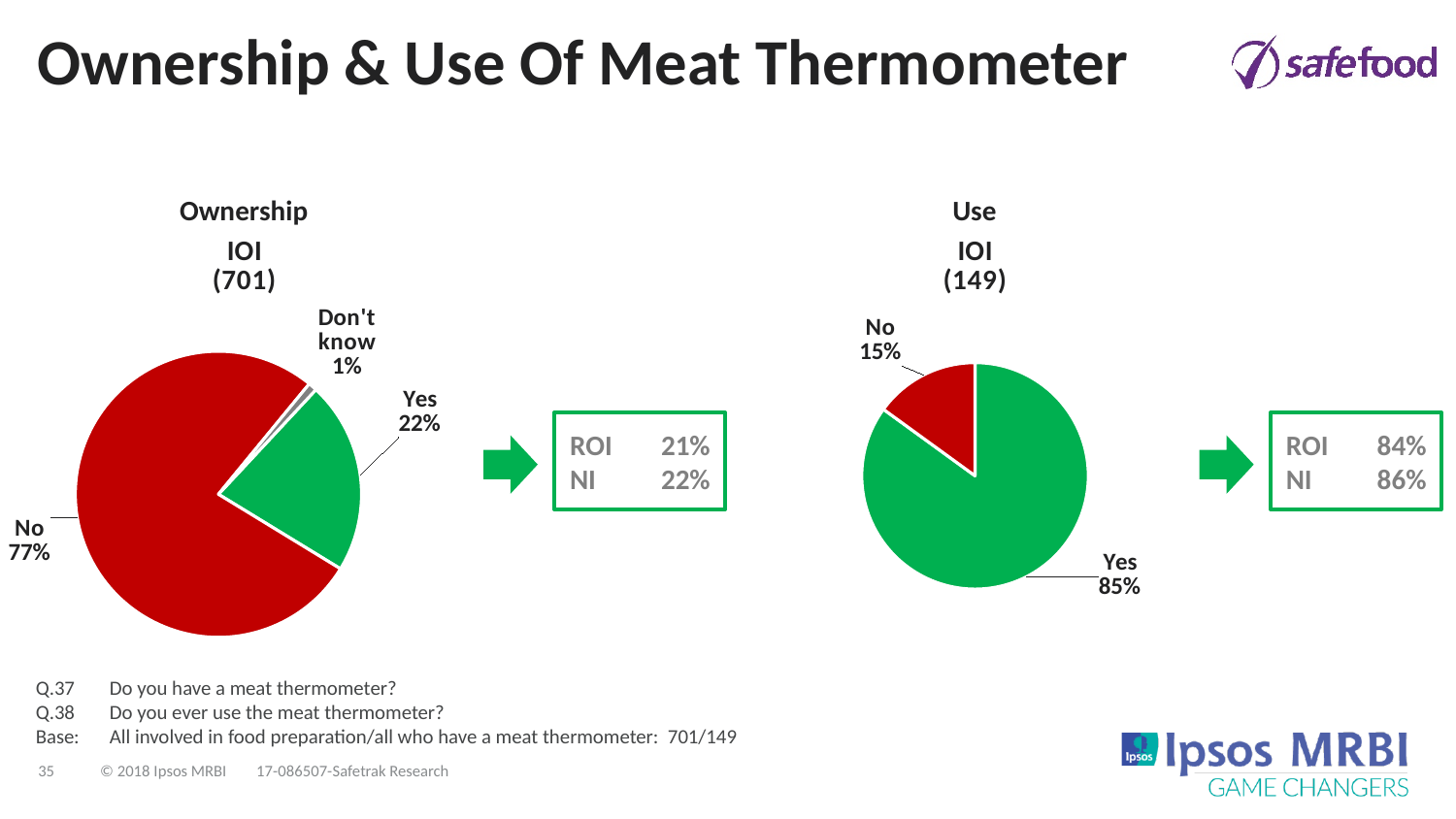
In the Ownership pie chart, which category has the largest share? No In the Ownership pie chart, which category has the smallest share? Don't know In the Ownership pie chart, what percentage answered Yes? 22% In the Use pie chart, what percentage answered Yes? 85% In the Ownership pie chart, what is the difference between the No and Yes percentages? 55% In the Use pie chart, which category has the largest share? Yes In the Use pie chart, what is the difference between the Yes and No percentages? 70% How many slices does the Ownership pie chart have? 3 In the Use pie chart, what percentage answered No? 15% What type of chart is used for the Use data? Pie chart In the Ownership pie chart, what percentage answered No? 77% In the Ownership pie chart, what percentage answered Don't know? 1%